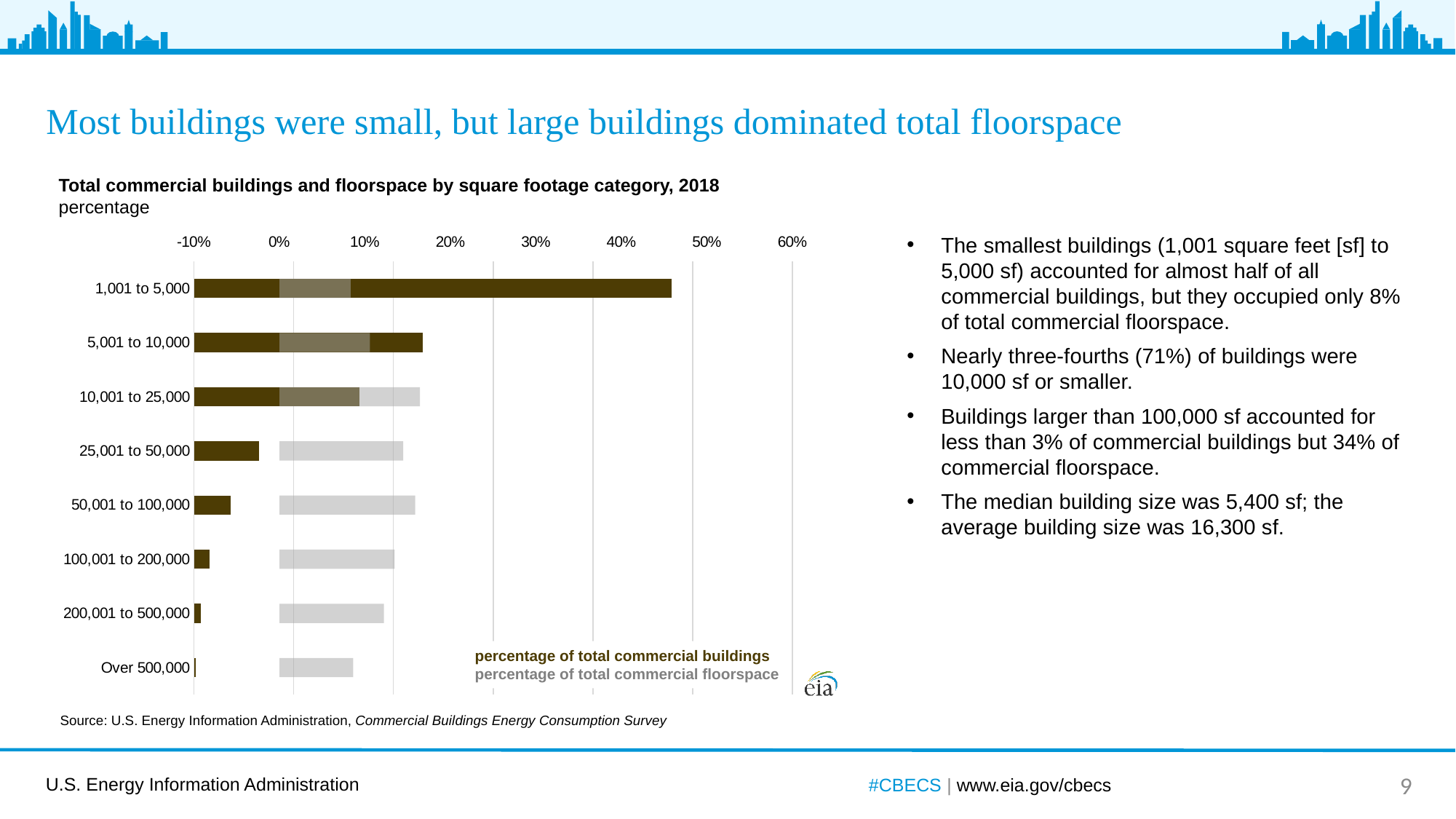
Is the percentage of total commercial floorspace for the 10,001 to 25,000 category greater or less than 10%? greater What is the title of the chart? Total commercial buildings and floorspace by square footage category, 2018 Is the percentage of total commercial buildings for the 100,001 to 200,000 category greater or less than 10%? less Which square footage category has the lowest percentage of total commercial buildings? Over 500,000 Which has a larger percentage of total commercial buildings: the 1,001 to 5,000 category or the 5,001 to 10,000 category? 1,001 to 5,000 Does the percentage of total commercial buildings rise or fall as the square footage category increases? fall How many series does the chart's legend list? 2 How many square footage categories are plotted on the chart? 8 Is the percentage of total commercial buildings for the 1,001 to 5,000 category greater or less than 30%? greater Which square footage category has the highest percentage of total commercial buildings? 1,001 to 5,000 What kind of chart is shown on the slide? bar chart Which series is shown in dark brown on the chart? percentage of total commercial buildings